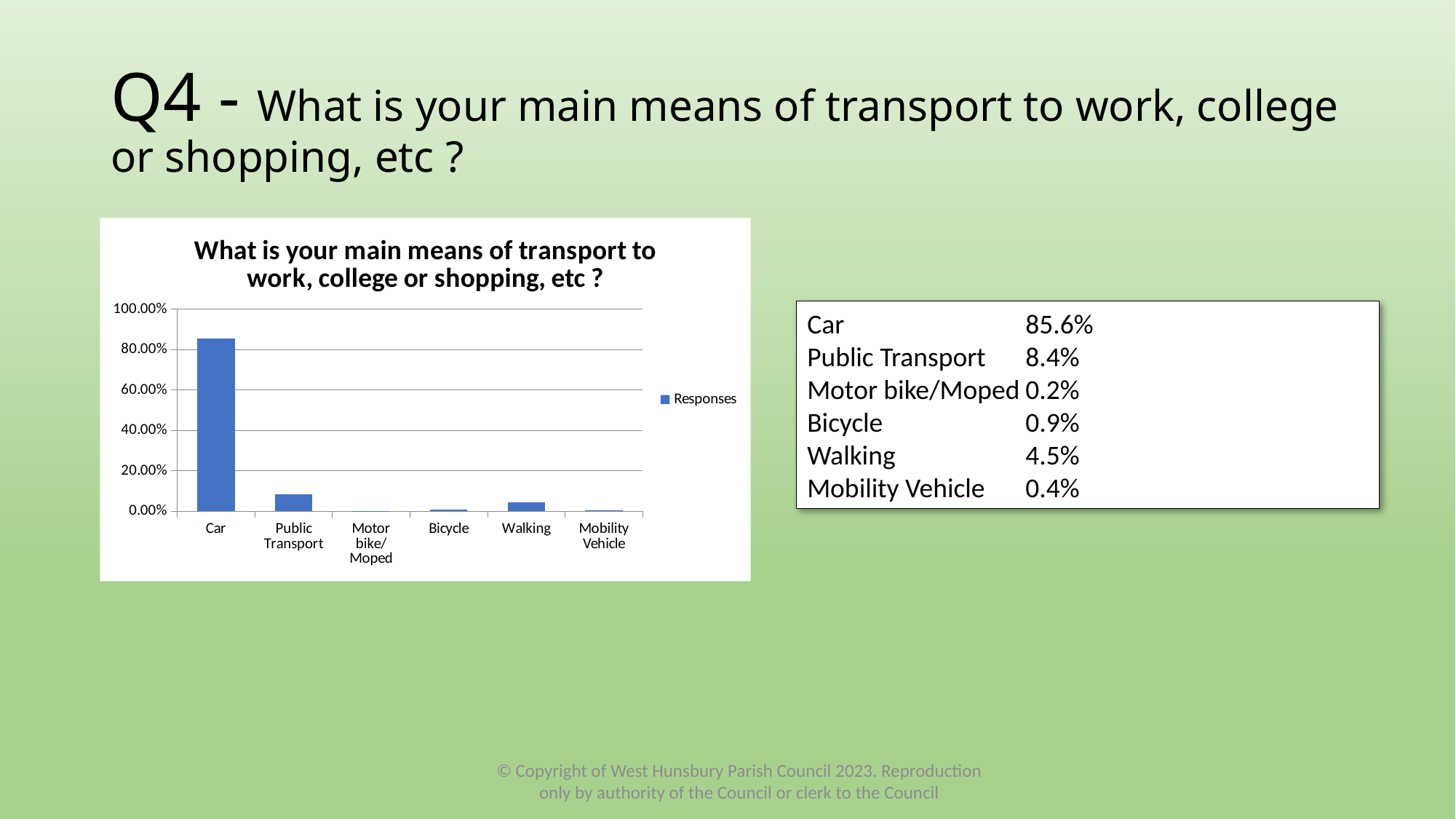
How many series does the chart legend list? 1 What is the difference between the value for Car and the value for Public Transport? 77.2% Which is larger, the value for Public Transport or the value for Walking? Public Transport What is the value for Public Transport? 8.4% Which category has the lowest value in the chart? Motor bike/Moped What kind of chart is shown on the slide? bar chart What is the value for Car? 85.6% What is the value for Walking? 4.5% Is the value for Car greater or less than 80.00%? greater How many categories are shown on the x axis of the chart? 6 What is the name of the series in the chart legend? Responses Which category has the highest value in the chart? Car